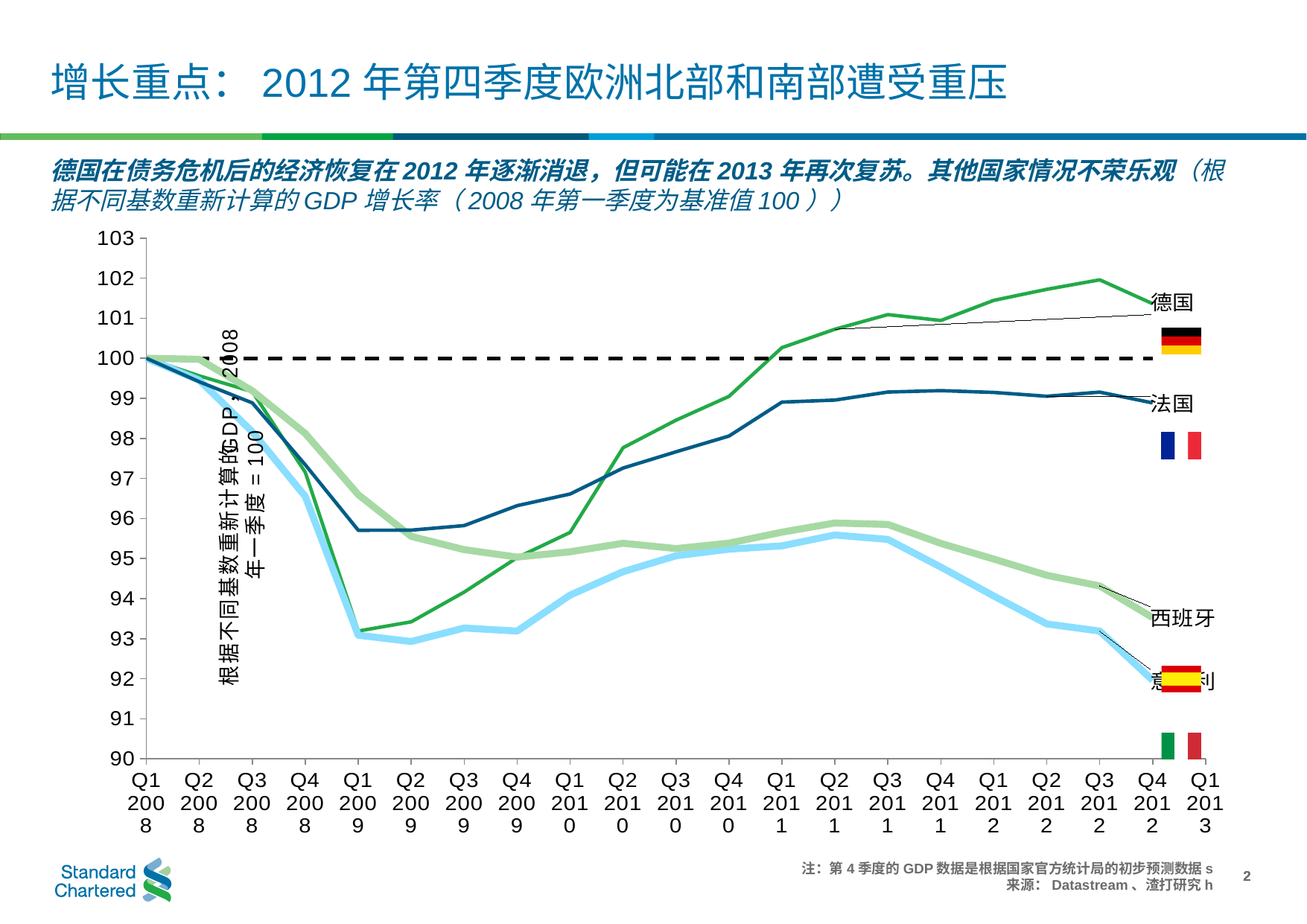
Does the value for 意大利 rise or fall from Q2 2011 to Q4 2012? fall How many quarters are shown on the x axis of the chart? 21 Which series has the highest value at Q4 2012? 德国 Is the value for 西班牙 at Q1 2009 greater or less than 94? greater How many series (countries) are plotted in the chart? 4 Is the value for 法国 at Q4 2012 greater or less than 100? less At Q4 2012, which is larger, the value for 西班牙 or the value for 意大利? 西班牙 Which series has the lowest value at Q4 2012? 意大利 Is the value for 意大利 at Q4 2012 greater or less than 93? less What is the value of every series at Q1 2008 in the chart? 100 What kind of chart is shown on the slide? line chart